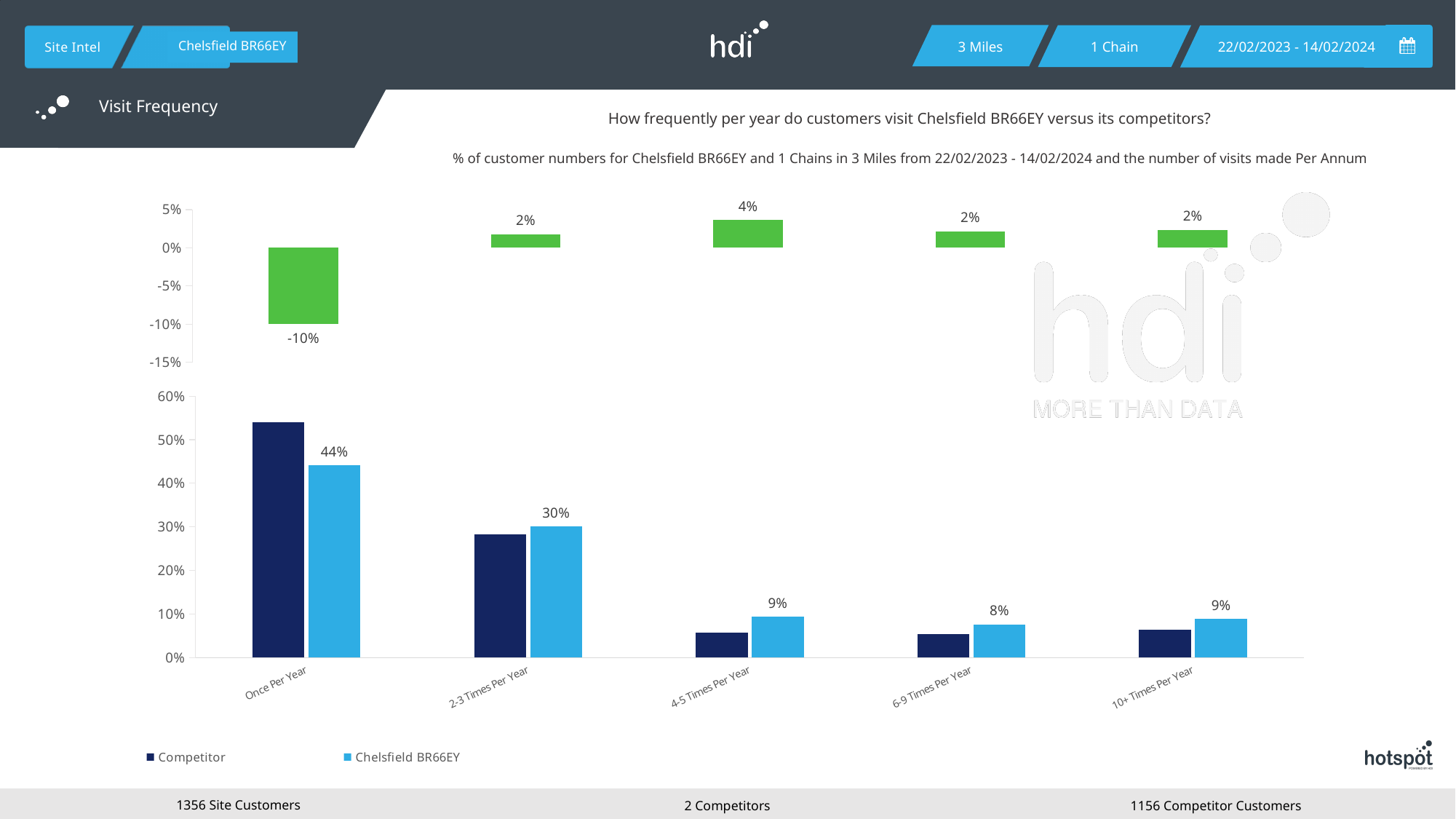
In the bottom chart, is the Competitor value for 4-5 Times Per Year greater or less than 10%? less How many visit-frequency categories are shown on the x axis of the bottom chart? 5 In the top green chart, which category has the highest value? 4-5 Times Per Year In the bottom chart, what is the value for Chelsfield BR66EY for 2-3 Times Per Year? 30% In the bottom chart, what is the difference between the Chelsfield BR66EY values for Once Per Year and 2-3 Times Per Year? 14% In the top green chart, what is the value for Once Per Year? -10% In the top green chart, which category has the lowest value? Once Per Year In the bottom chart, which is larger for Once Per Year: Competitor or Chelsfield BR66EY? Competitor In the top green chart, what is the value for 4-5 Times Per Year? 4% In the bottom chart, what is the value for Chelsfield BR66EY for Once Per Year? 44% In the bottom chart, is the Competitor value for Once Per Year greater or less than 50%? greater How many series does the legend of the bottom chart list? 2